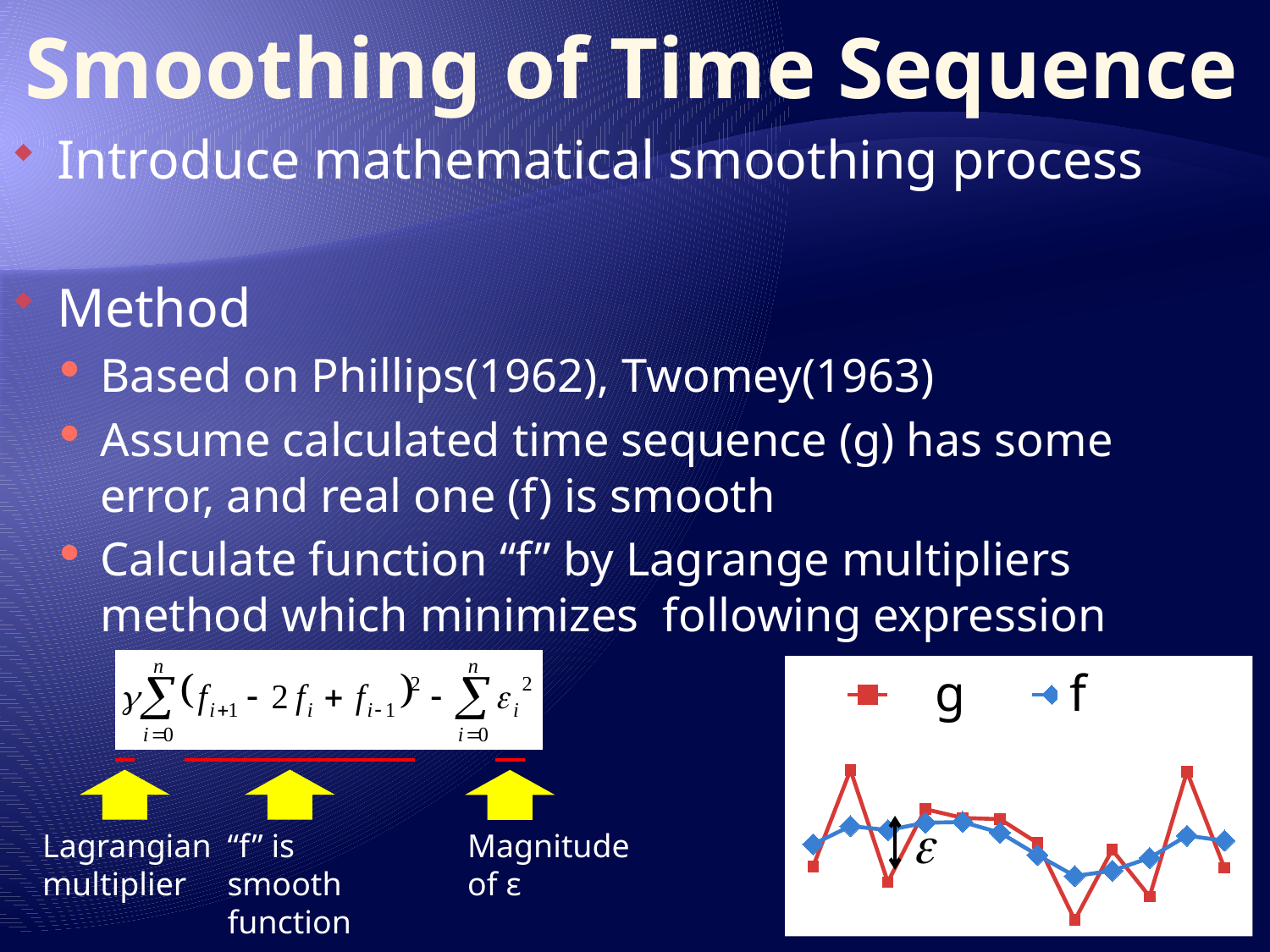
Which series in the chart shows larger fluctuations from point to point, g or f? g What are the names of the two series in the chart's legend? g and f Which colour is used for the series g in the chart? red Which series in the chart is the smoother one, g or f? f How many series does the legend of the chart list? 2 What kind of chart is shown at the bottom right of the slide? line chart